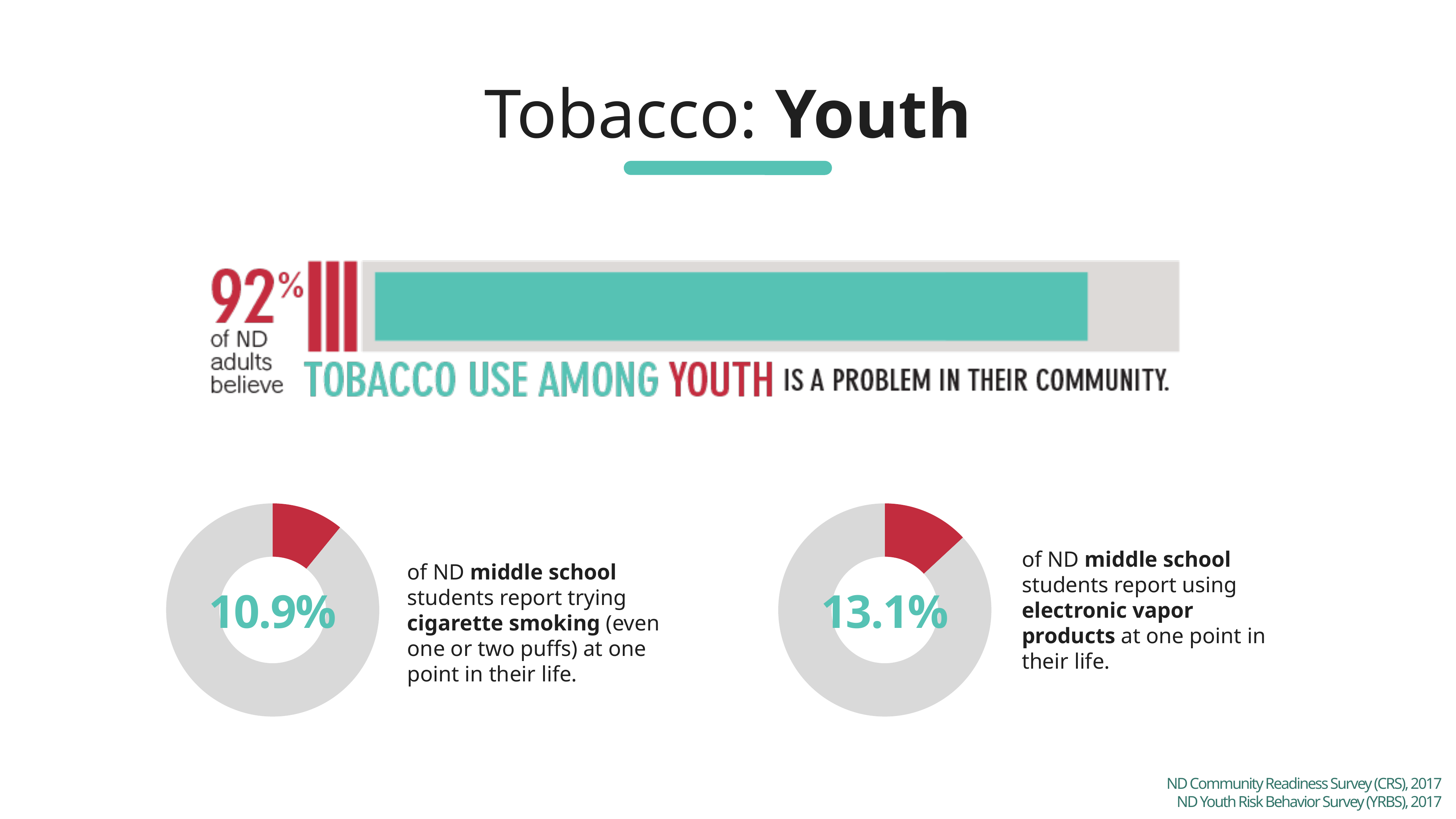
In the bottom-left donut chart, what percentage of ND middle school students report trying cigarette smoking at one point in their life? 10.9% Of the three percentages charted on the slide, which is the highest? 92% (ND adults who believe tobacco use among youth is a problem) How many donut charts are shown on the slide? 2 In the top bar chart, what percentage of ND adults believe tobacco use among youth is a problem in their community? 92% What kind of chart is used to show the 92% statistic at the top of the slide? Bar chart In the bottom-right donut chart, what percentage of ND middle school students report using electronic vapor products at one point in their life? 13.1% What kind of chart is used to show the 10.9% cigarette smoking statistic at the bottom left of the slide? Donut chart What colour is the filled slice in the two donut charts at the bottom of the slide? Red What colour is the filled portion of the top bar chart showing 92%? Teal What is the difference between the electronic vapor products percentage (13.1%) and the cigarette smoking percentage (10.9%) shown in the two donut charts? 2.2 percentage points Comparing the two donut charts, which is larger: the share of ND middle school students who tried cigarette smoking or the share who used electronic vapor products? Electronic vapor products (13.1%) Of the three percentages charted on the slide, which is the lowest? 10.9% (middle school students who tried cigarette smoking)